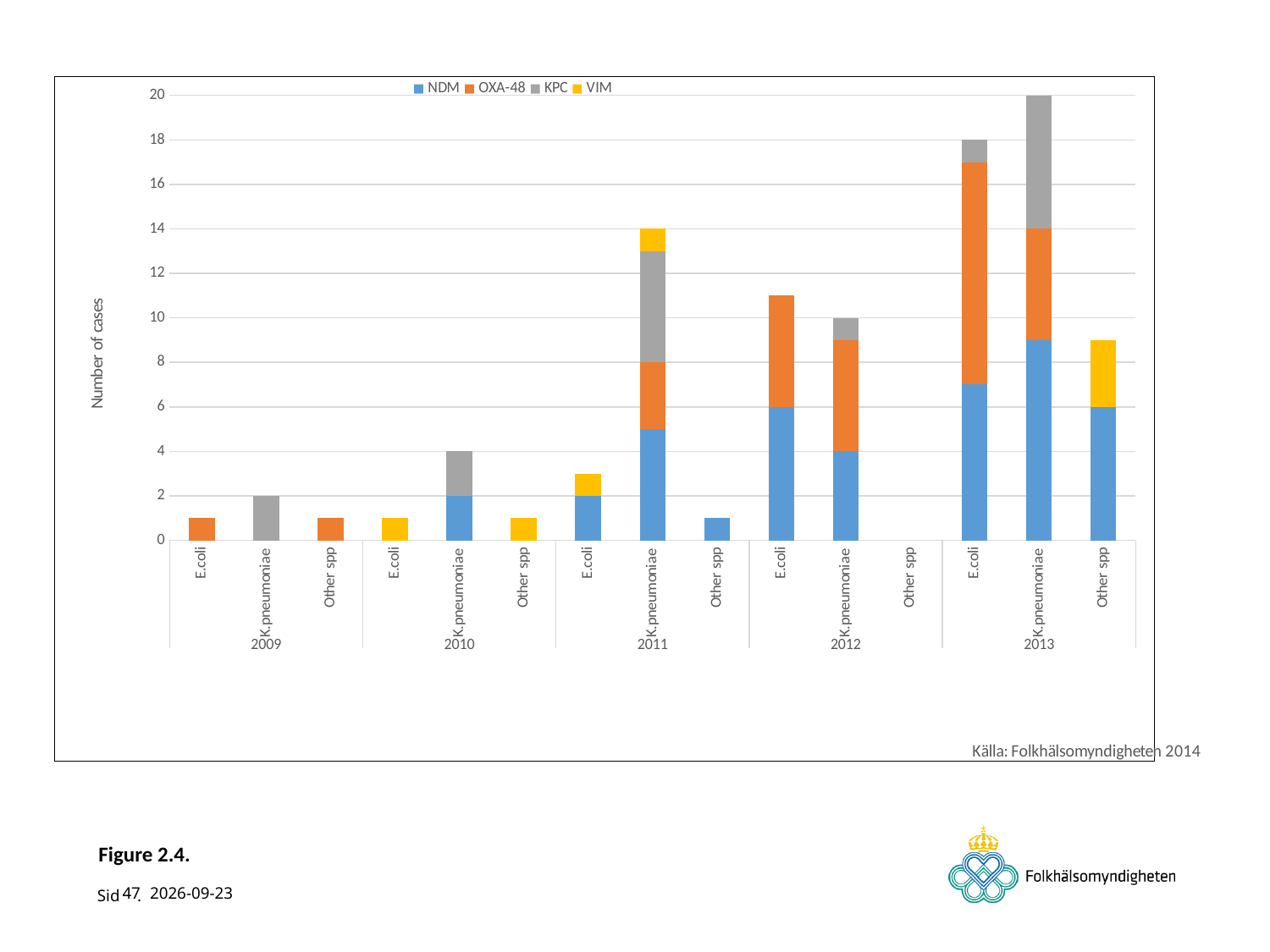
What is the label of the vertical axis? Number of cases How many years are shown along the x axis? 5 Is the total for E.coli in 2012 greater or less than 10? greater What is the total number of cases for K.pneumoniae in 2011? 14 What kind of chart is shown on the slide? stacked bar chart Which bar has the highest total number of cases? K.pneumoniae in 2013 What is the total number of cases for E.coli in 2013? 18 What is the total number of cases for K.pneumoniae in 2012? 10 Which series are listed in the legend? NDM, OXA-48, KPC, VIM Which is larger, the total for E.coli in 2013 or the total for E.coli in 2012? E.coli in 2013 How many series does the legend list? 4